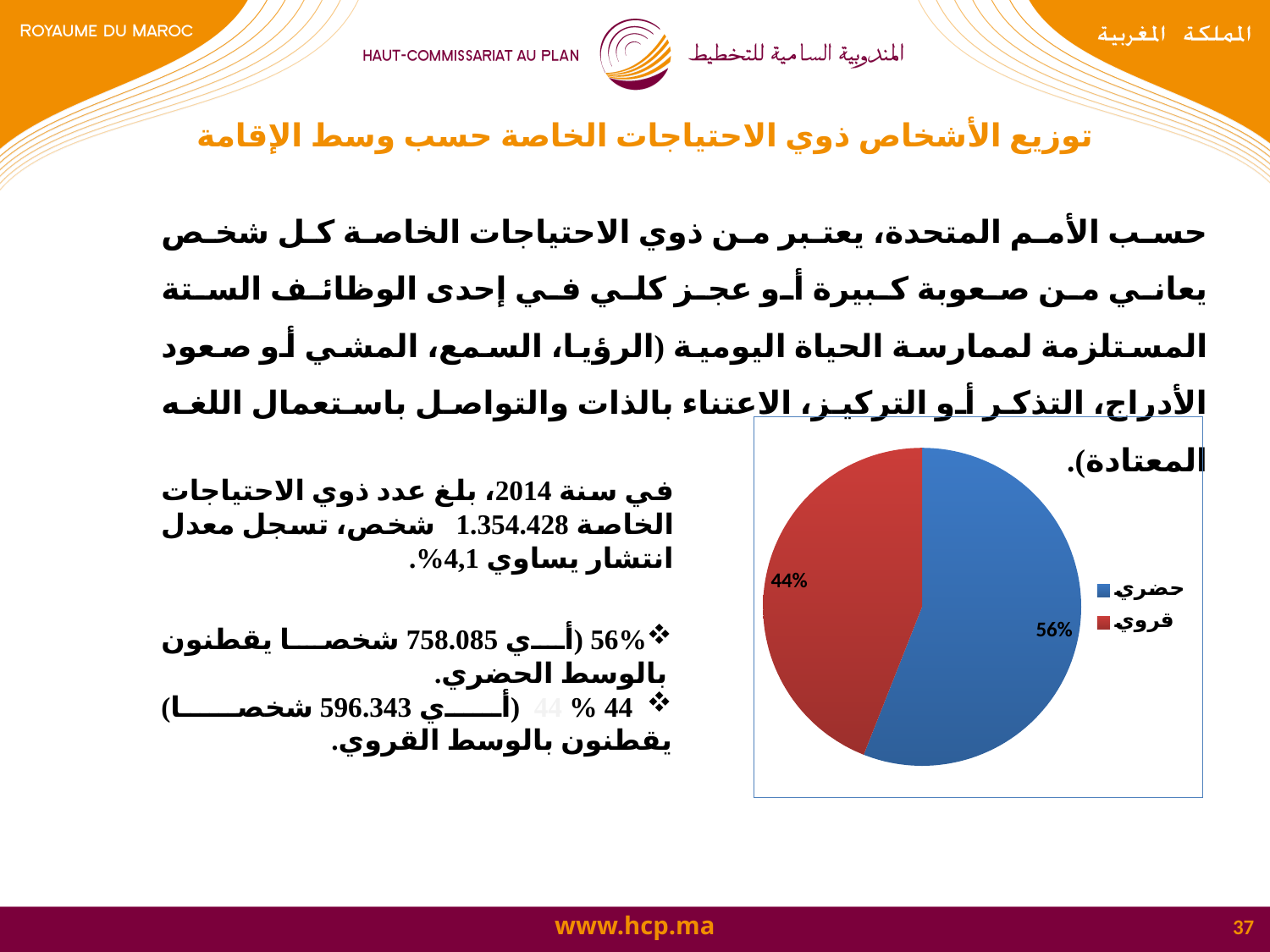
Which category has the smallest slice of the pie? قروي How many slices does the pie chart have? 2 What colour is the حضري slice in the pie chart? blue What kind of chart is shown on the slide? pie chart How many entries does the legend list? 2 What share of the pie does the قروي slice represent? 44% Which slice is larger, حضري or قروي? حضري Is the share for قروي greater or less than 50%? less What is the difference in percentage points between the حضري and قروي slices? 12 What share of the pie does the حضري slice represent? 56% Which category has the largest slice of the pie? حضري What colour is the قروي slice in the pie chart? red